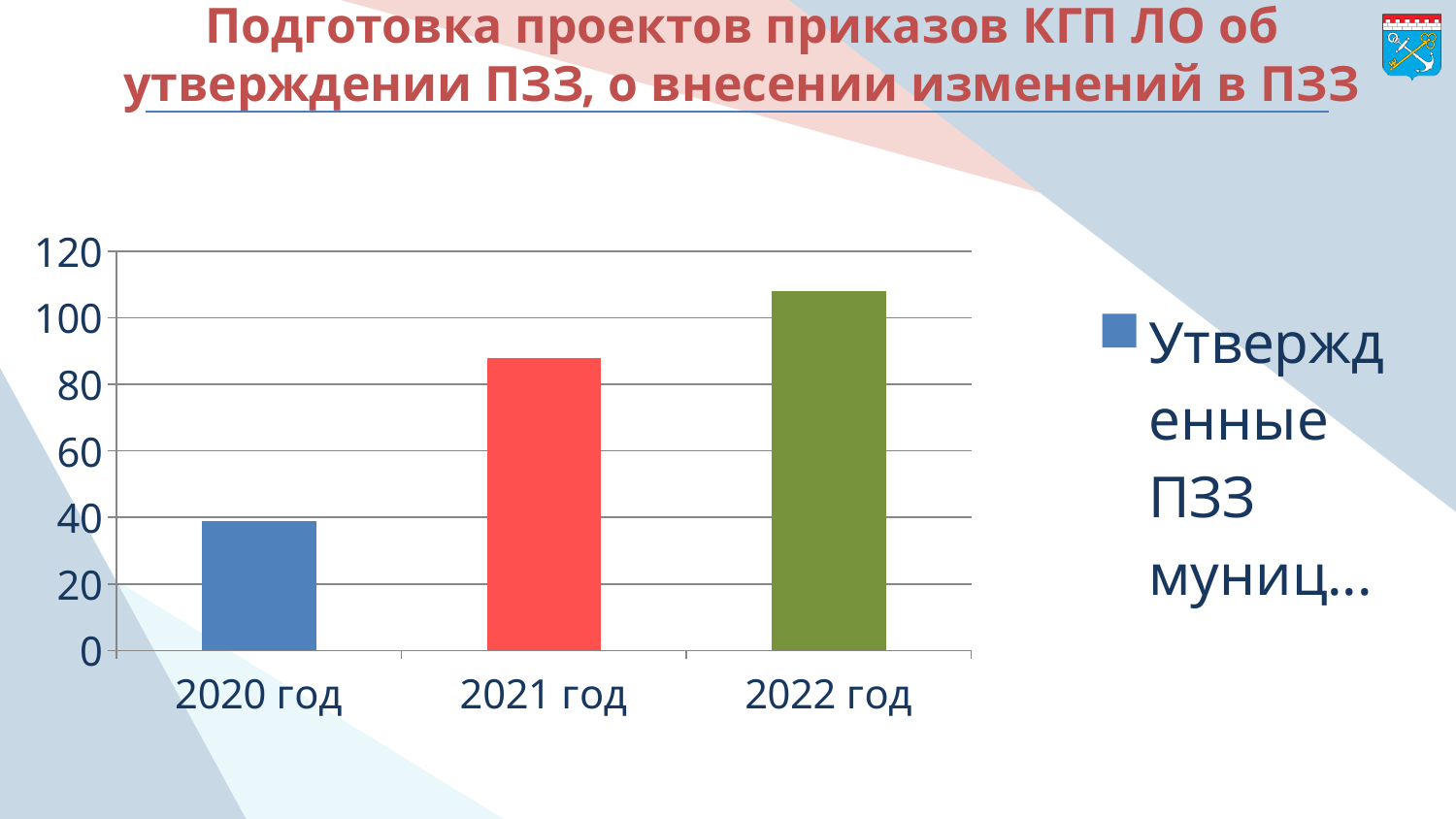
Do the values rise or fall from 2020 год to 2022 год? rise How many series does the legend list? 1 Is the value for 2021 год greater or less than 80? greater What is the maximum value shown on the vertical axis? 120 Which year has the lowest bar? 2020 год Is the value for 2022 год greater or less than 100? greater Which is larger, the value for 2021 год or the value for 2020 год? 2021 год How many categories (years) are shown on the x axis? 3 Is the value for 2021 год greater or less than 100? less What kind of chart is shown on the slide? bar chart Which year has the highest bar? 2022 год